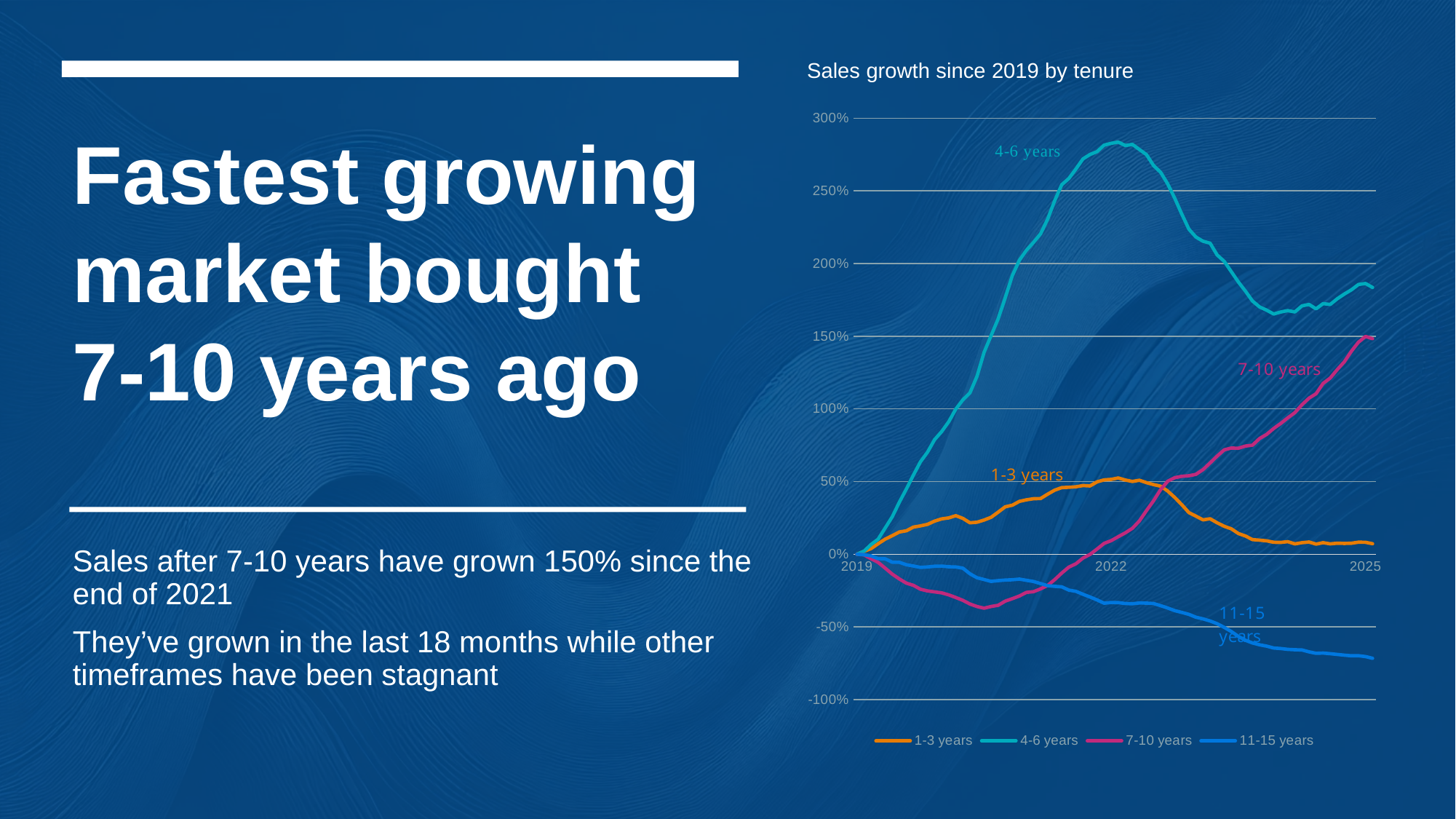
Is the value for 11-15 years at 2025 greater or less than -50%? less Does the 7-10 years series rise or fall from 2022 to 2025? rise Which series reaches the highest value anywhere on the chart? 4-6 years What kind of chart is shown on the slide? Line chart Is the value for 7-10 years at 2025 greater or less than 100%? greater What is the title of the chart? Sales growth since 2019 by tenure Is the value for 1-3 years at 2025 greater or less than 50%? less Which series has the lowest value at 2025? 11-15 years At 2025, which series is higher: 4-6 years or 7-10 years? 4-6 years Does the 11-15 years series generally rise or fall from 2019 to 2025? fall How many series does the chart legend list? 4